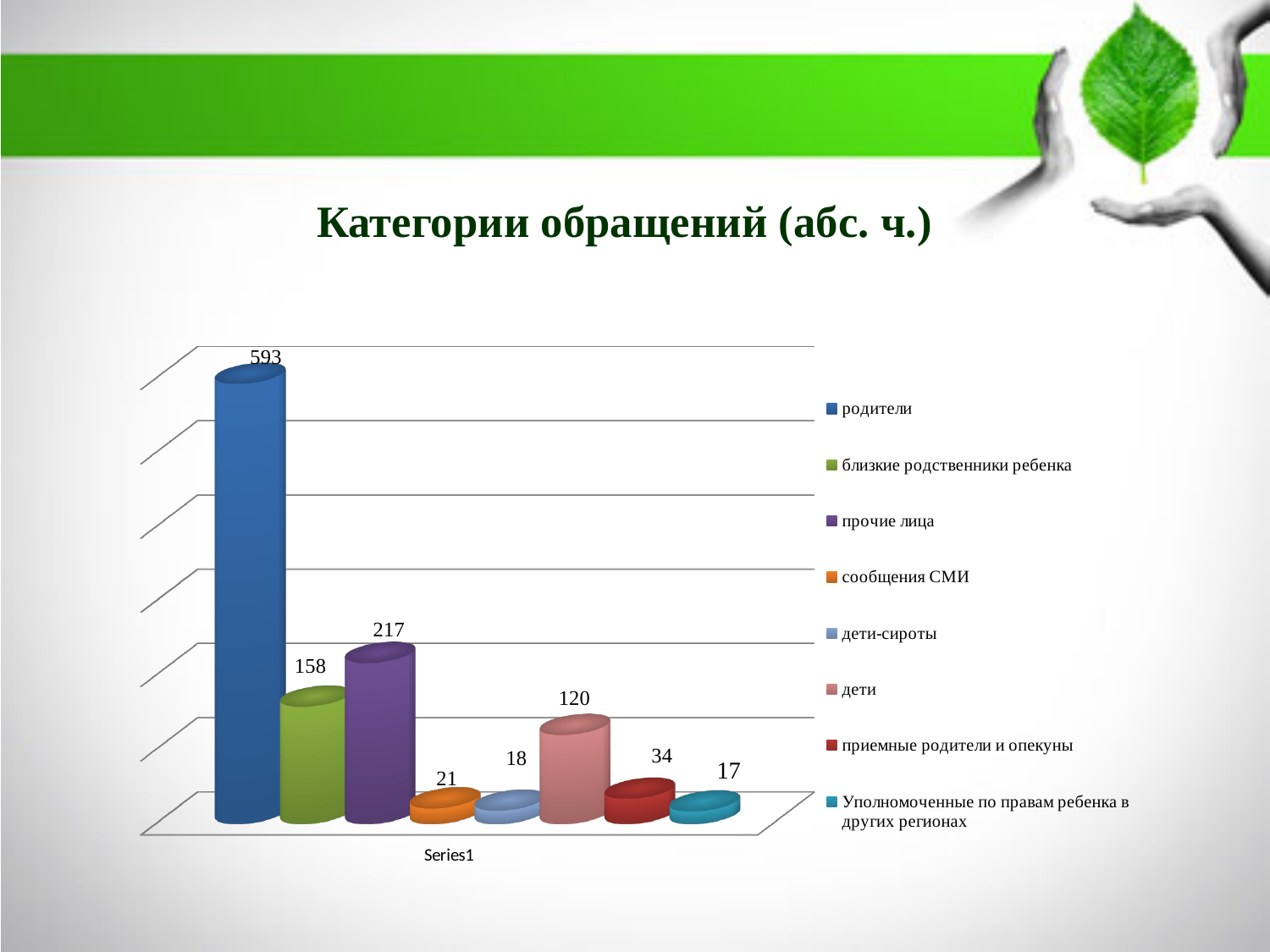
What is the difference between the values for дети and близкие родственники ребенка? 38 What is the title of the chart? Категории обращений (абс. ч.) How many categories are shown in the chart? 8 What is the value for прочие лица? 217 What is the difference between the values for родители and прочие лица? 376 Which category has the highest value? родители What is the value for дети? 120 Which is larger, the value for приемные родители и опекуны or the value for дети-сироты? приемные родители и опекуны What kind of chart is shown on the slide? bar chart Which category has the lowest value? Уполномоченные по правам ребенка в других регионах What is the value for родители? 593 What is the value for сообщения СМИ? 21